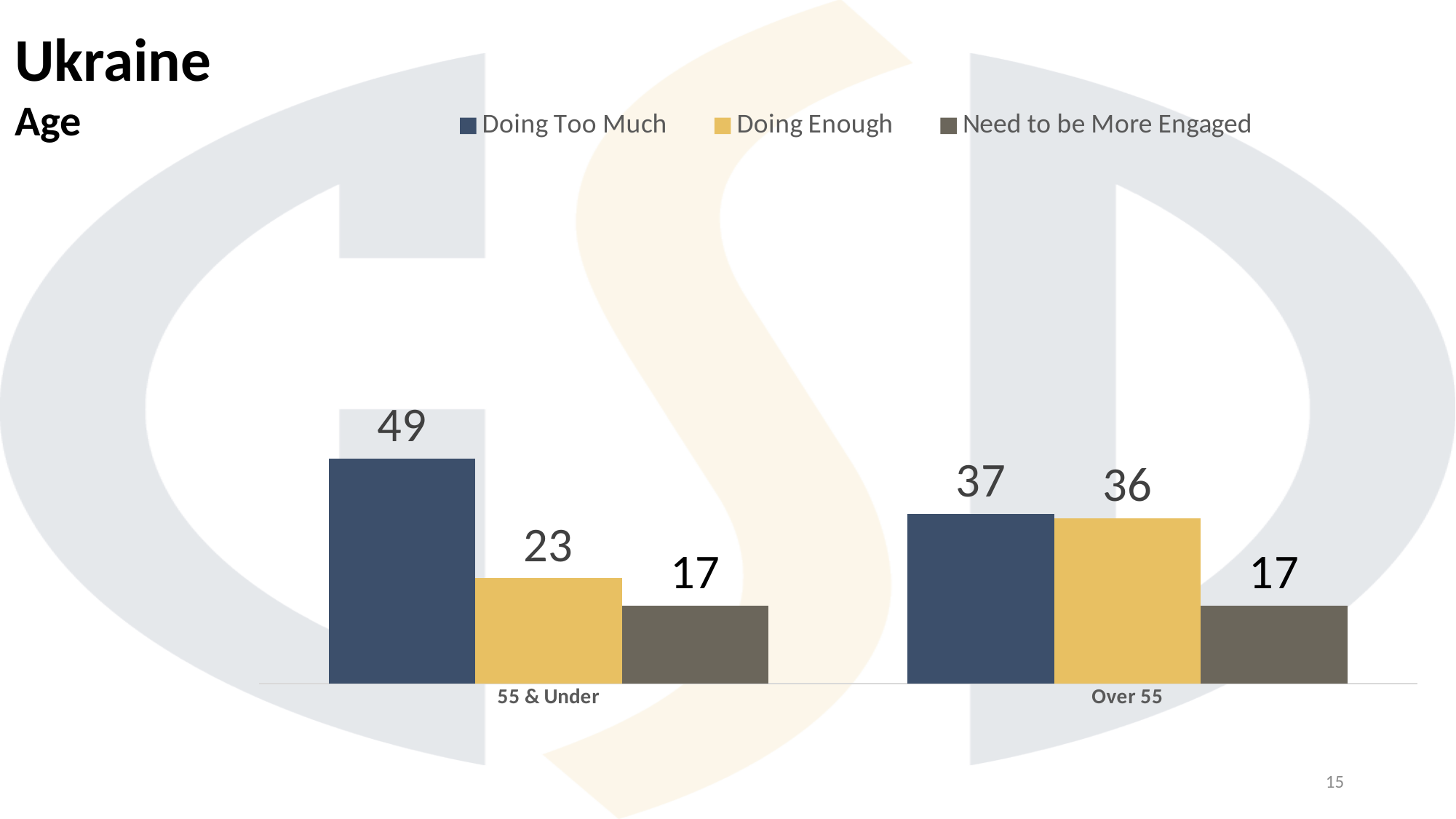
Which series has the highest value in the 55 & Under group? Doing Too Much What is the value for Doing Too Much in the Over 55 group? 37 What is the difference between the Doing Too Much values for 55 & Under and Over 55? 12 How many age categories are shown on the x axis? 2 What is the difference between Doing Too Much and Doing Enough in the 55 & Under group? 26 Which series has the lowest value in the Over 55 group? Need to be More Engaged Which is larger: Doing Enough for 55 & Under or Doing Enough for Over 55? Over 55 What is the value for Doing Enough in the Over 55 group? 36 What is the value for Need to be More Engaged in the 55 & Under group? 17 What is the value for Doing Too Much in the 55 & Under group? 49 How many series does the legend list? 3 What kind of chart is shown on the slide? Bar chart